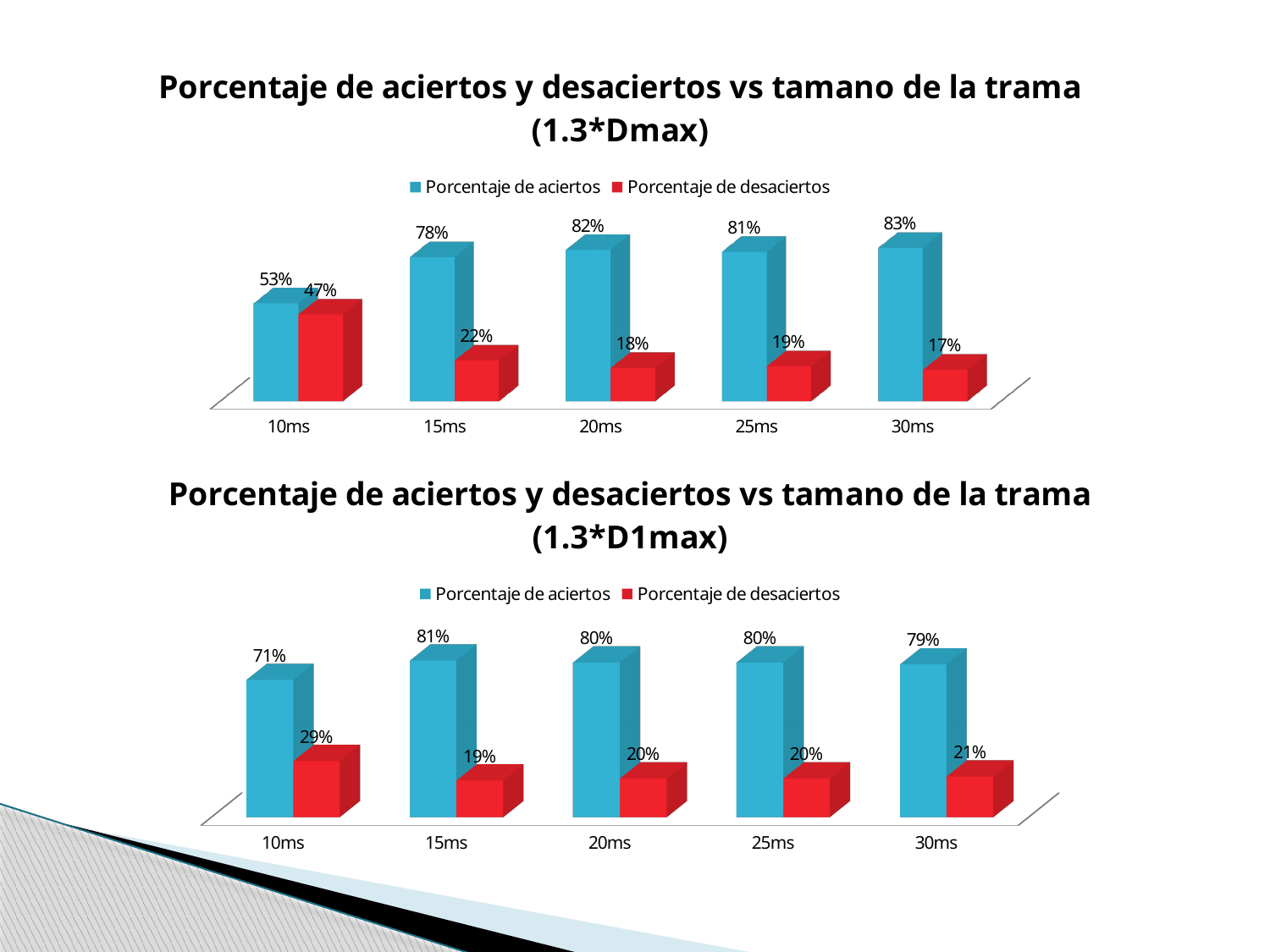
In the top chart (1.3*Dmax), what is the Porcentaje de desaciertos for 30ms? 17% In the bottom chart (1.3*D1max), which frame size has the highest Porcentaje de desaciertos? 10ms What kind of chart is the top chart (1.3*Dmax)? Bar chart In the top chart (1.3*Dmax), what is the difference between Porcentaje de aciertos and Porcentaje de desaciertos at 10ms? 6% In the bottom chart (1.3*D1max), what is the Porcentaje de desaciertos for 25ms? 20% How many frame-size categories are shown on the x axis of the top chart (1.3*Dmax)? 5 How many series does the legend of the bottom chart (1.3*D1max) list? 2 In the top chart (1.3*Dmax), which frame size has the lowest Porcentaje de aciertos? 10ms In the bottom chart (1.3*D1max), is the Porcentaje de aciertos at 15ms larger or smaller than at 30ms? larger In the top chart (1.3*Dmax), which frame size has the highest Porcentaje de aciertos? 30ms In the bottom chart (1.3*D1max), what is the Porcentaje de aciertos for 10ms? 71% In the top chart (1.3*Dmax), what is the Porcentaje de aciertos for 15ms? 78%